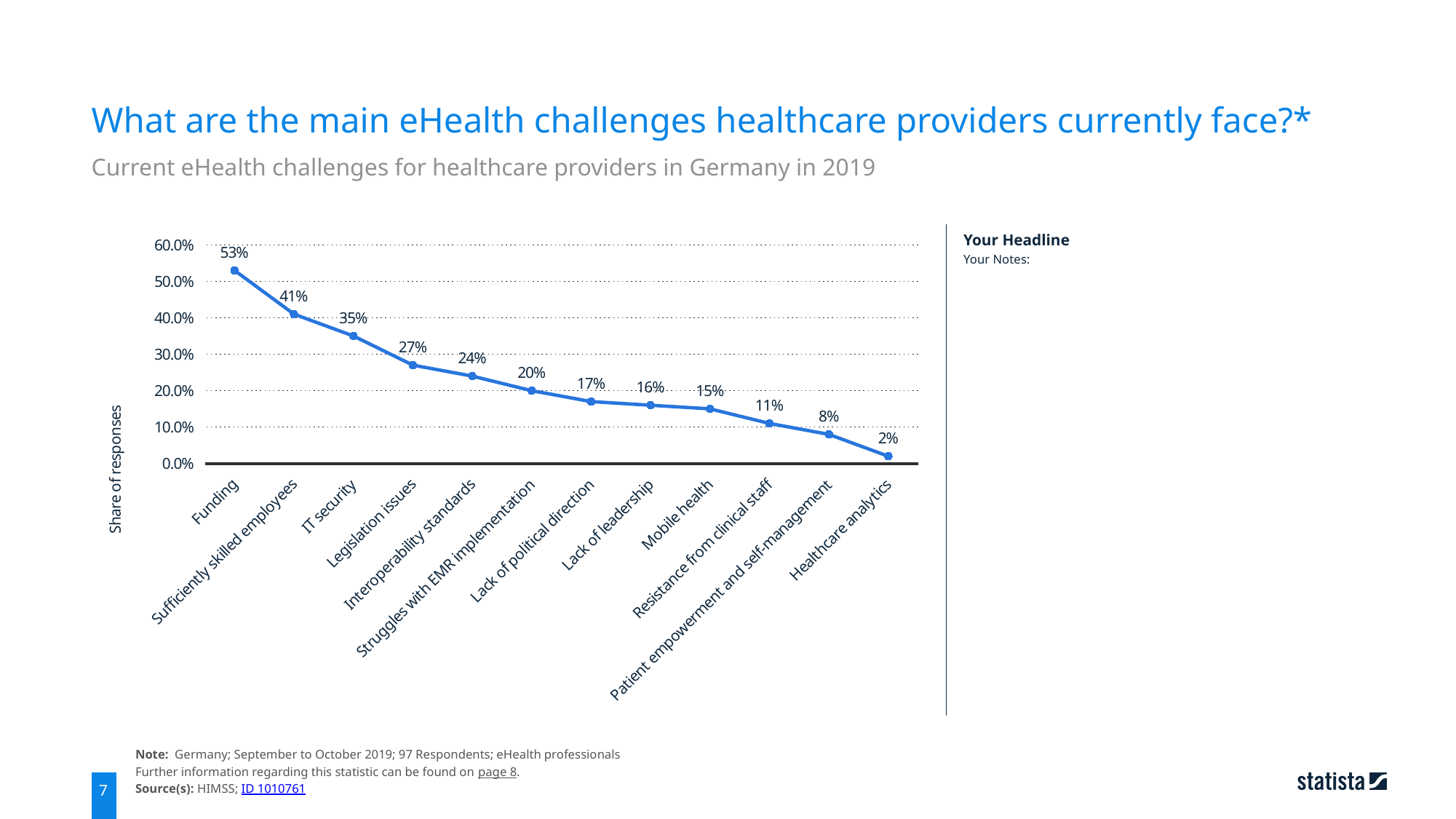
Which challenge has the highest share of responses? Funding What is the share of responses for Lack of leadership? 16% How many challenges are plotted on the chart? 12 What is the difference in share of responses between Funding and Sufficiently skilled employees? 12% Do the values rise or fall from left to right along the x axis? Fall What is the share of responses for Patient empowerment and self-management? 8% What is the share of responses for IT security? 35% What kind of chart is shown on the slide? Line chart Which has a larger share of responses, Legislation issues or Mobile health? Legislation issues Which challenge has the lowest share of responses? Healthcare analytics What is the label of the vertical axis? Share of responses What is the share of responses for Funding? 53%